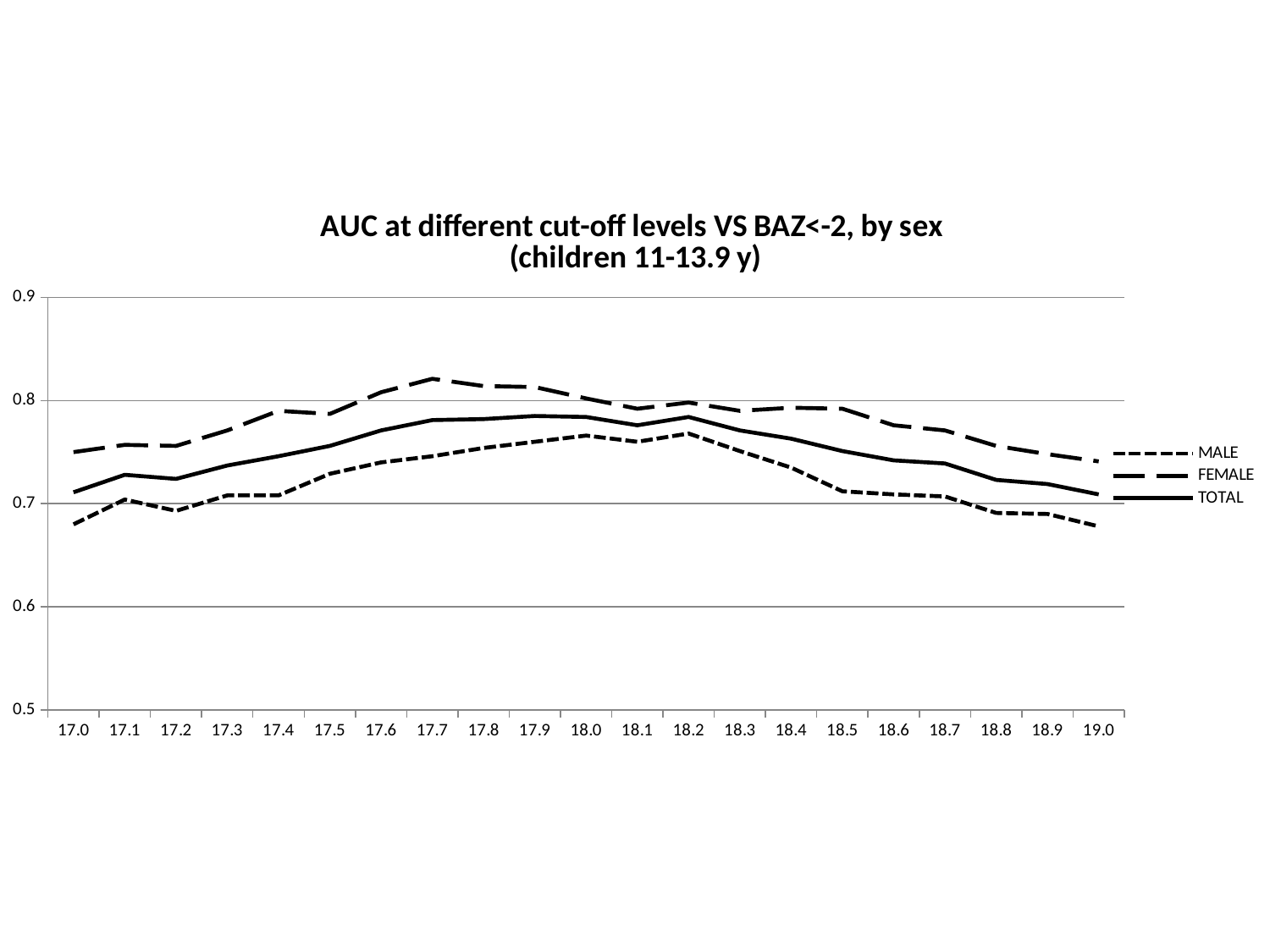
Is the FEMALE value at cut-off 17.7 greater or less than 0.8? greater How many series does the legend list? 3 Which series has the lowest values across the cut-off levels? MALE How many cut-off levels are shown along the x axis? 21 Is the FEMALE value at cut-off 19.0 greater or less than 0.7? greater At which cut-off level does the FEMALE series reach its highest value? 17.7 At cut-off 17.7, which is larger, the FEMALE value or the MALE value? FEMALE Does the MALE series rise or fall from cut-off 18.2 to 19.0? fall Is the TOTAL value at cut-off 18.2 greater or less than 0.8? less What age group is named in the chart title? children 11-13.9 y What kind of chart is shown on the slide? line chart